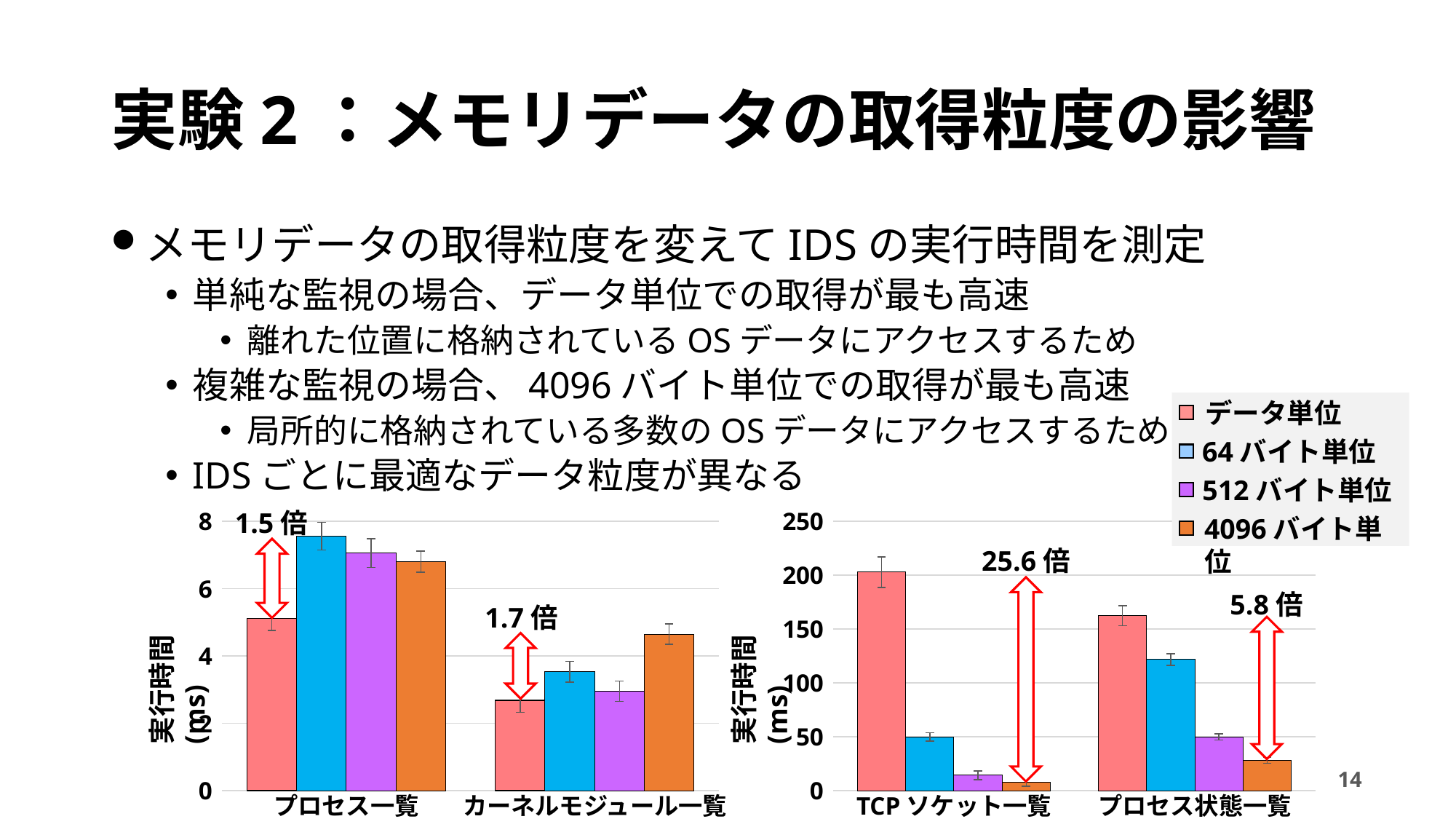
In the left chart, which is larger for プロセス一覧: データ単位 or 64 バイト単位? 64 バイト単位 In the right chart, which series has the highest value for TCP ソケット一覧? データ単位 In the right chart, is the value of データ単位 for プロセス状態一覧 greater or less than 150? greater In the left chart, which series has the highest value for カーネルモジュール一覧? 4096 バイト単位 How many categories are shown on the x axis of the right chart? 2 How many series does the legend list for the charts? 4 In the right chart, which series has the lowest value for プロセス状態一覧? 4096 バイト単位 In the left chart, which series has the lowest value for プロセス一覧? データ単位 What type of chart is the left chart on the slide? bar chart In the right chart, is the value of 64 バイト単位 for TCP ソケット一覧 greater or less than 100? less What ratio is annotated above the TCP ソケット一覧 bars in the right chart? 25.6 倍 In the left chart, is the value of データ単位 for プロセス一覧 greater or less than 4? greater